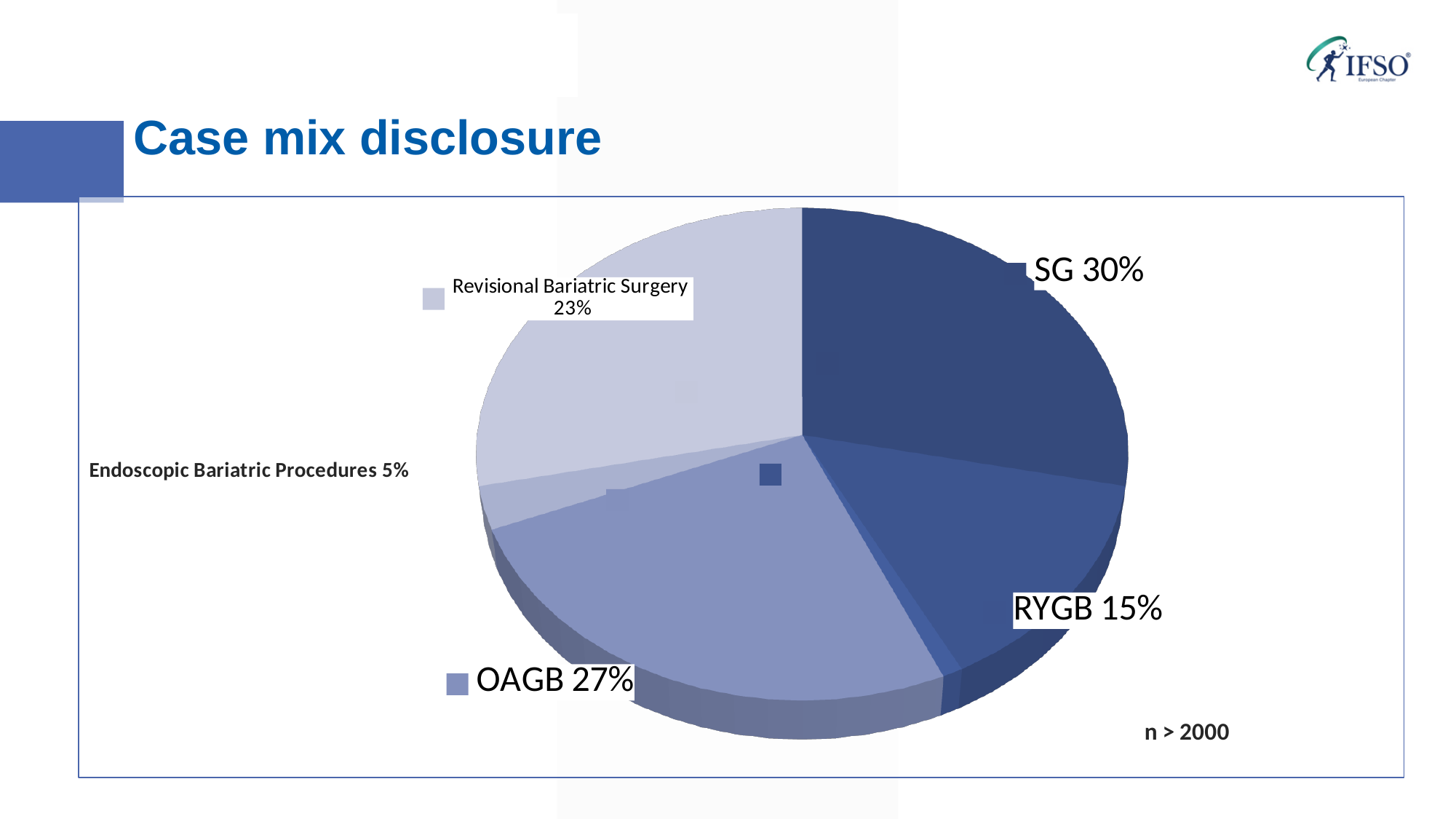
Which category has the largest slice of the pie? SG What share of the pie does OAGB represent? 27% What share of the pie does Revisional Bariatric Surgery represent? 23% Which is larger, the OAGB slice or the Revisional Bariatric Surgery slice? OAGB What is the title of the slide containing the chart? Case mix disclosure What is the difference in percentage points between SG and RYGB? 15 What share of the pie does RYGB represent? 15% What share of the pie does SG represent? 30% Which category has the smallest slice of the pie? Endoscopic Bariatric Procedures What share of the pie do Endoscopic Bariatric Procedures represent? 5% What kind of chart is shown on the slide? Pie chart